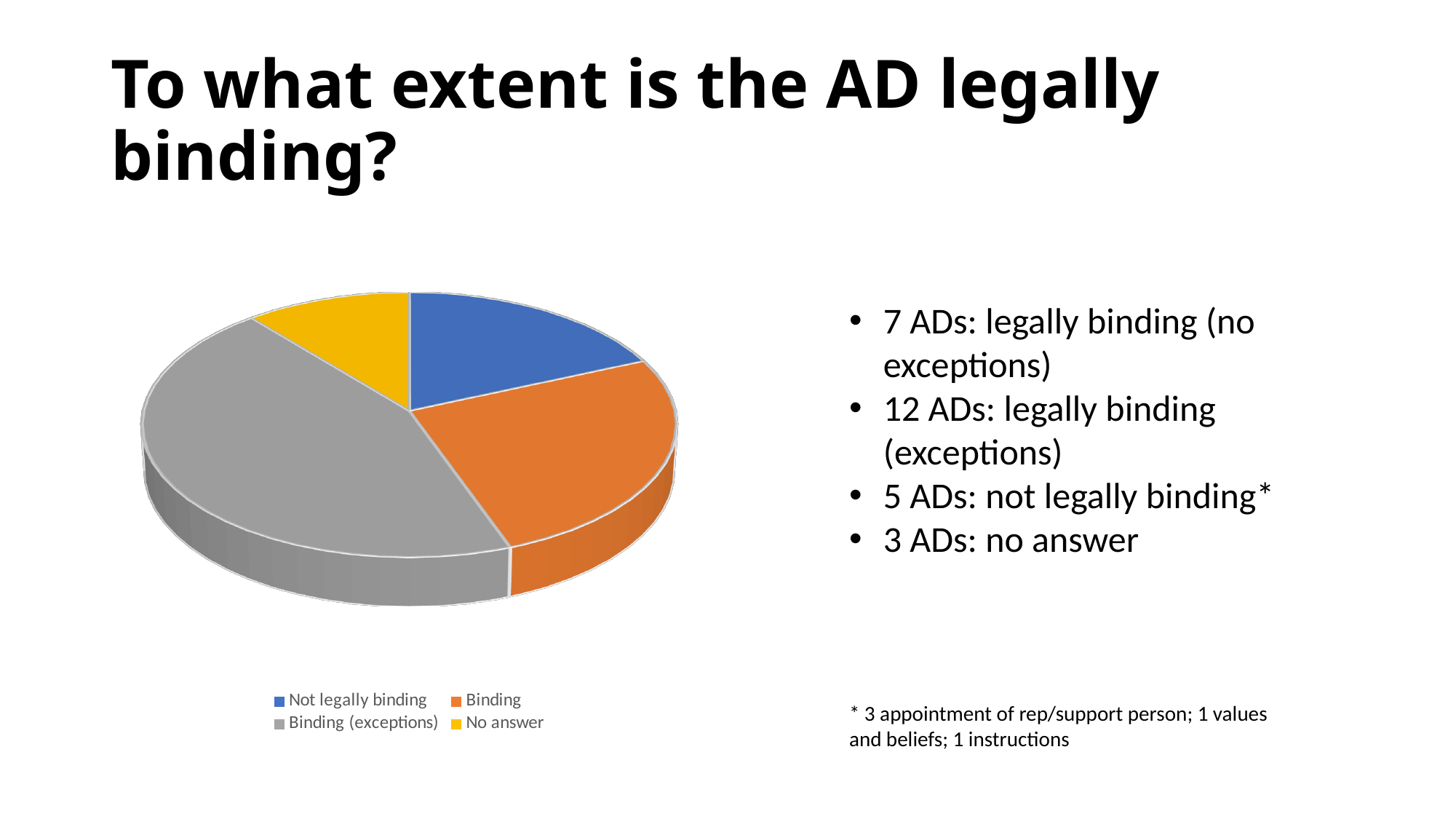
According to the slide, how many ADs are legally binding with exceptions? 12 ADs What kind of chart is shown on the slide? pie chart What colour is the Binding (exceptions) slice in the pie chart? gray Which category has the largest slice in the pie chart? Binding (exceptions) According to the slide, how many more ADs are legally binding with exceptions than legally binding with no exceptions? 5 Which slice is larger in the pie chart, Binding or Not legally binding? Binding Which category has the smallest slice in the pie chart? No answer Which slice is larger in the pie chart, Not legally binding or No answer? Not legally binding How many entries does the legend of the pie chart list? 4 How many slices does the pie chart have? 4 What is the title of the slide containing the pie chart? To what extent is the AD legally binding? According to the slide, how many ADs gave no answer? 3 ADs